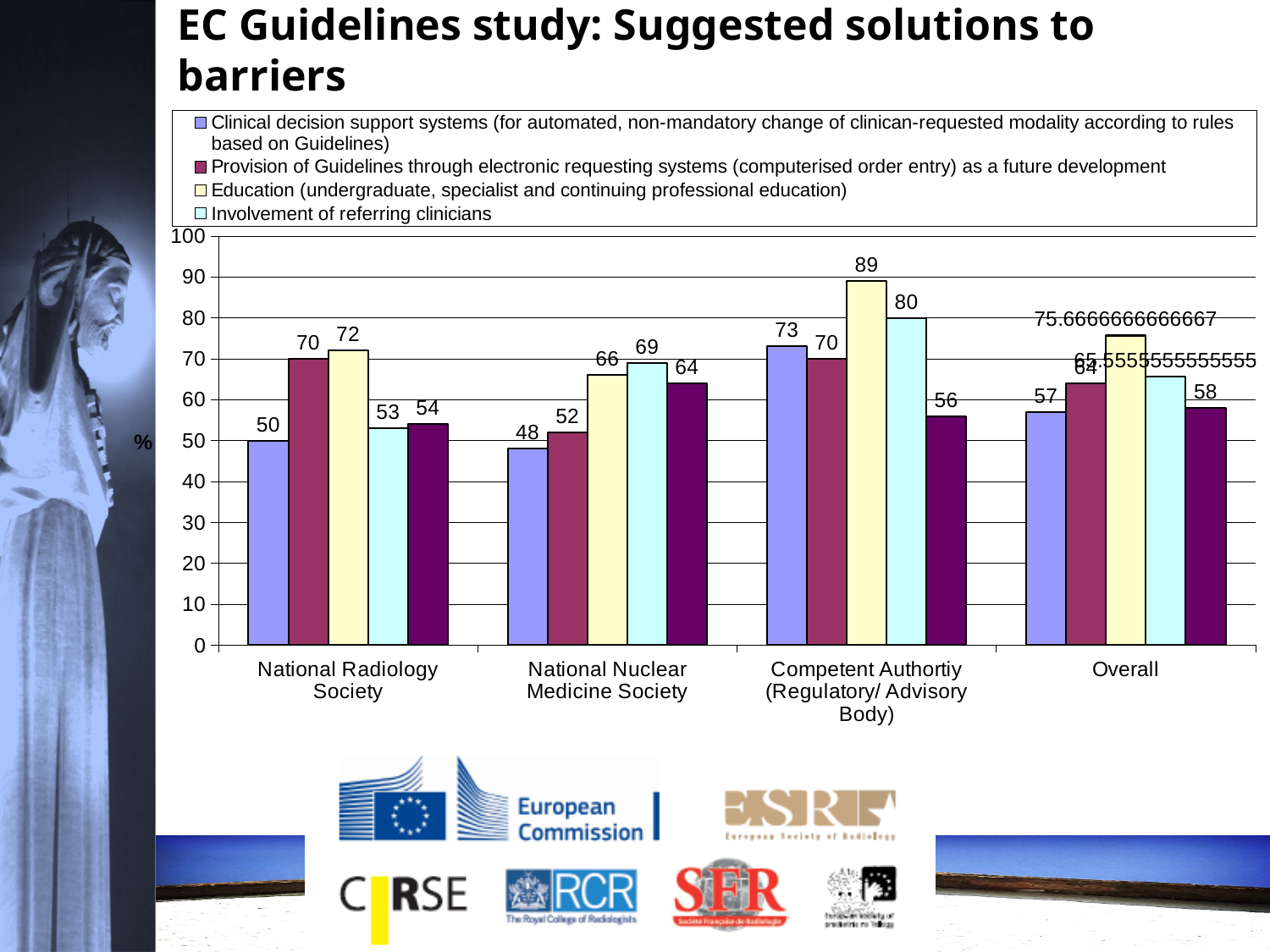
What unit label is shown on the y axis of the chart? % How many series does the chart's legend list? 4 Which category has the highest value for Education? Competent Authortiy (Regulatory/ Advisory Body) Is the Education value for the Overall category greater or less than 70? greater Is the value for Involvement of referring clinicians larger for the Competent Authortiy (Regulatory/ Advisory Body) or for the National Radiology Society? Competent Authortiy (Regulatory/ Advisory Body) Which category has the lowest value for Clinical decision support systems? National Nuclear Medicine Society What is the value for Education for the Competent Authortiy (Regulatory/ Advisory Body) category? 89 For the Competent Authortiy (Regulatory/ Advisory Body), what is the difference between the Education value and the Clinical decision support systems value? 16 What is the value for Provision of Guidelines through electronic requesting systems for the National Nuclear Medicine Society? 52 What is the value for Clinical decision support systems for the National Radiology Society? 50 What kind of chart is shown on the slide? bar chart How many categories are shown along the x axis of the chart? 4